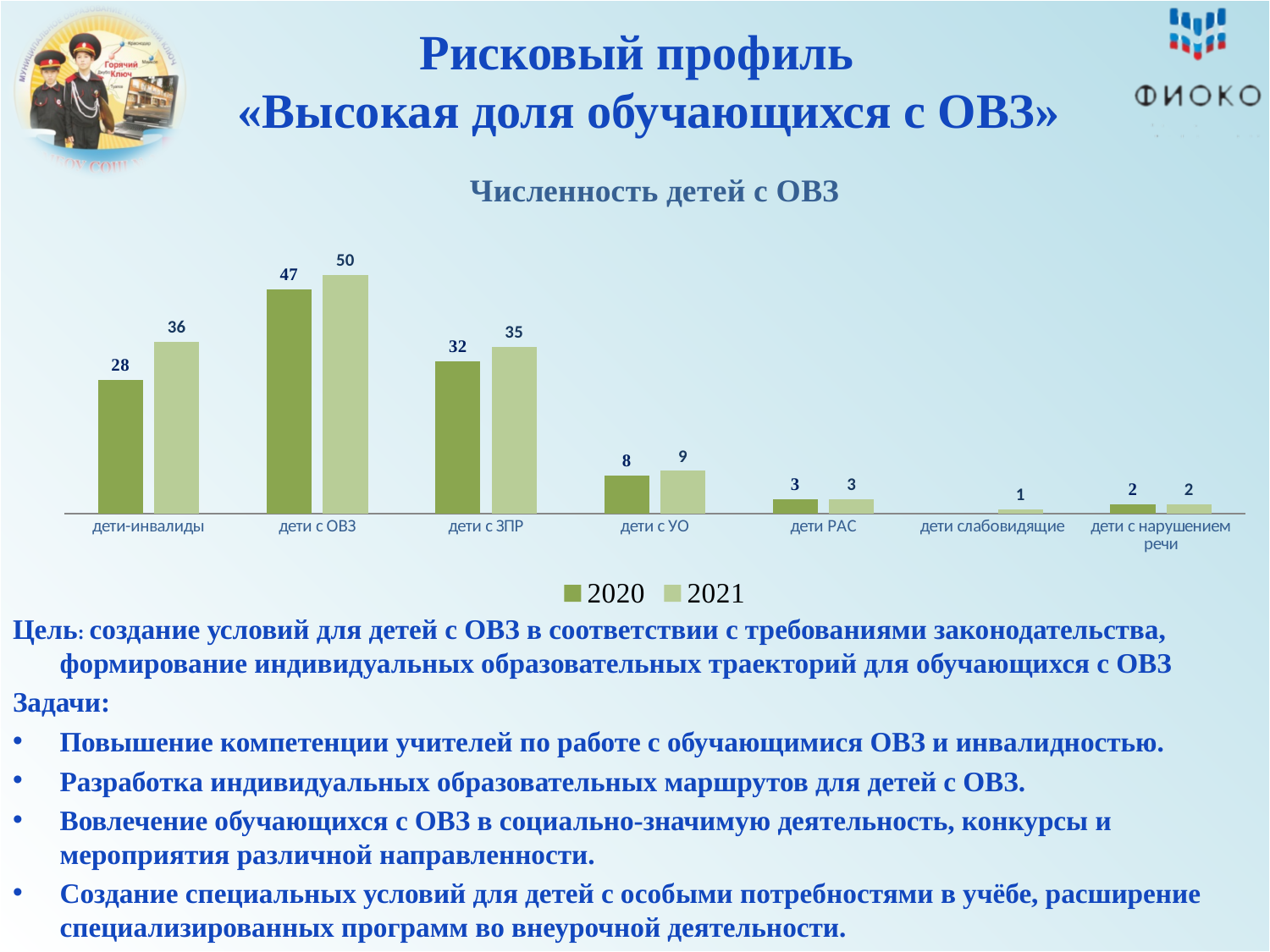
How many series does the legend list? 2 What is the value for дети-инвалиды in 2021? 36 What is the value for дети с нарушением речи in 2020? 2 Which is larger: the 2020 value for дети с ОВЗ or the 2020 value for дети с ЗПР? дети с ОВЗ What type of chart is shown on the slide? bar chart How many categories are shown on the x axis of the chart? 7 What is the value for дети с УО in 2021? 9 What is the title of the chart? Численность детей с ОВЗ Which category has the highest value in 2021? дети с ОВЗ What is the value for дети с ЗПР in 2020? 32 Which category has the lowest value in 2021? дети слабовидящие What is the difference between the 2021 and 2020 values for дети-инвалиды? 8